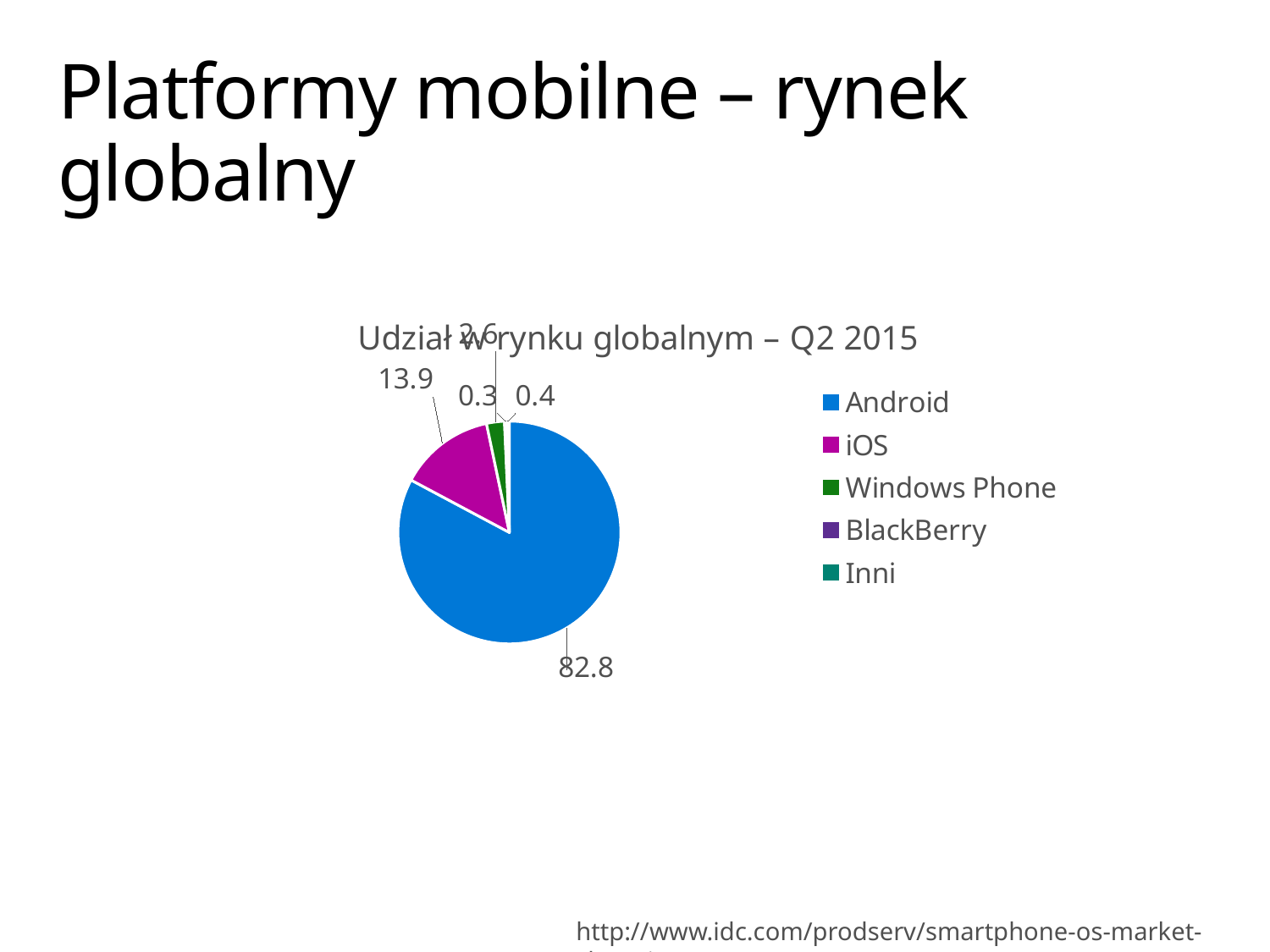
Which has a larger slice, iOS or Windows Phone? iOS Which has a larger slice, Android or iOS? Android What colour is the Android slice in the pie chart? Blue Which platform has the largest slice of the pie chart? Android What kind of chart is shown on the slide? Pie chart What is the difference between the Android value and the iOS value? 68.9 What is the value shown for Android in the pie chart? 82.8 What is the title of the chart? Udział w rynku globalnym – Q2 2015 How many categories are shown in the pie chart? 5 How many entries does the legend list? 5 What is the value shown for iOS in the pie chart? 13.9